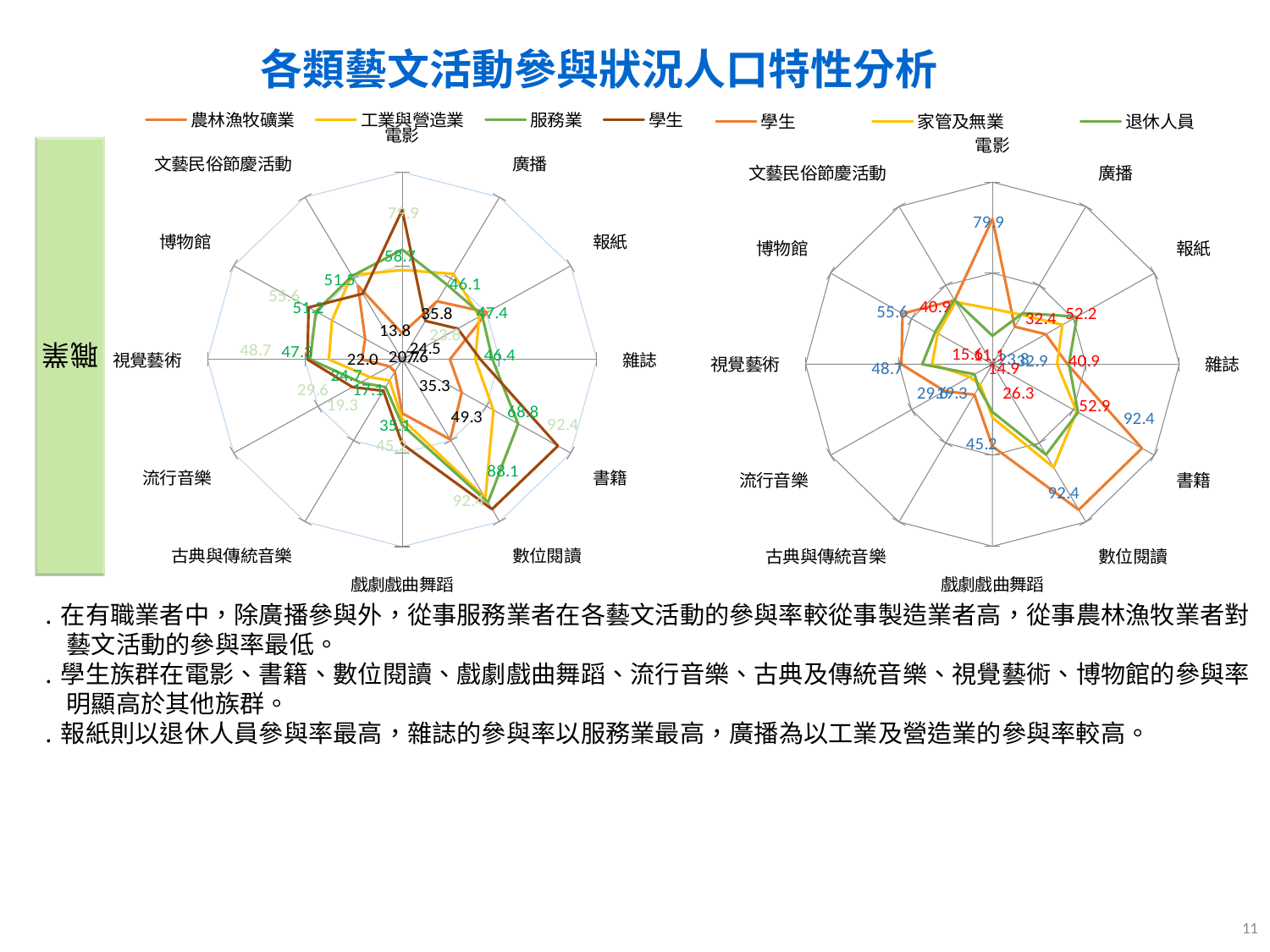
How many categories (axes) does the right radar chart have? 12 How many series does the legend of the left chart list? 4 In the right chart, what is the value for 學生 in 電影? 79.9 Which series are listed in the legend of the right chart? 學生, 家管及無業, 退休人員 In the right chart, what is the value for 學生 in 博物館? 55.6 In the right chart, what is the value for 學生 in 書籍? 92.4 What kind of chart is the left chart on the slide? Radar chart In the right chart, what is the difference between the 學生 values for 書籍 (92.4) and 電影 (79.9)? 12.5 In the right chart, what is the value for 學生 in 視覺藝術? 48.7 How many series does the legend of the right chart list? 3 In the right chart, which is larger for 學生: 電影 or 書籍? 書籍 What is the title of the slide? 各類藝文活動參與狀況人口特性分析